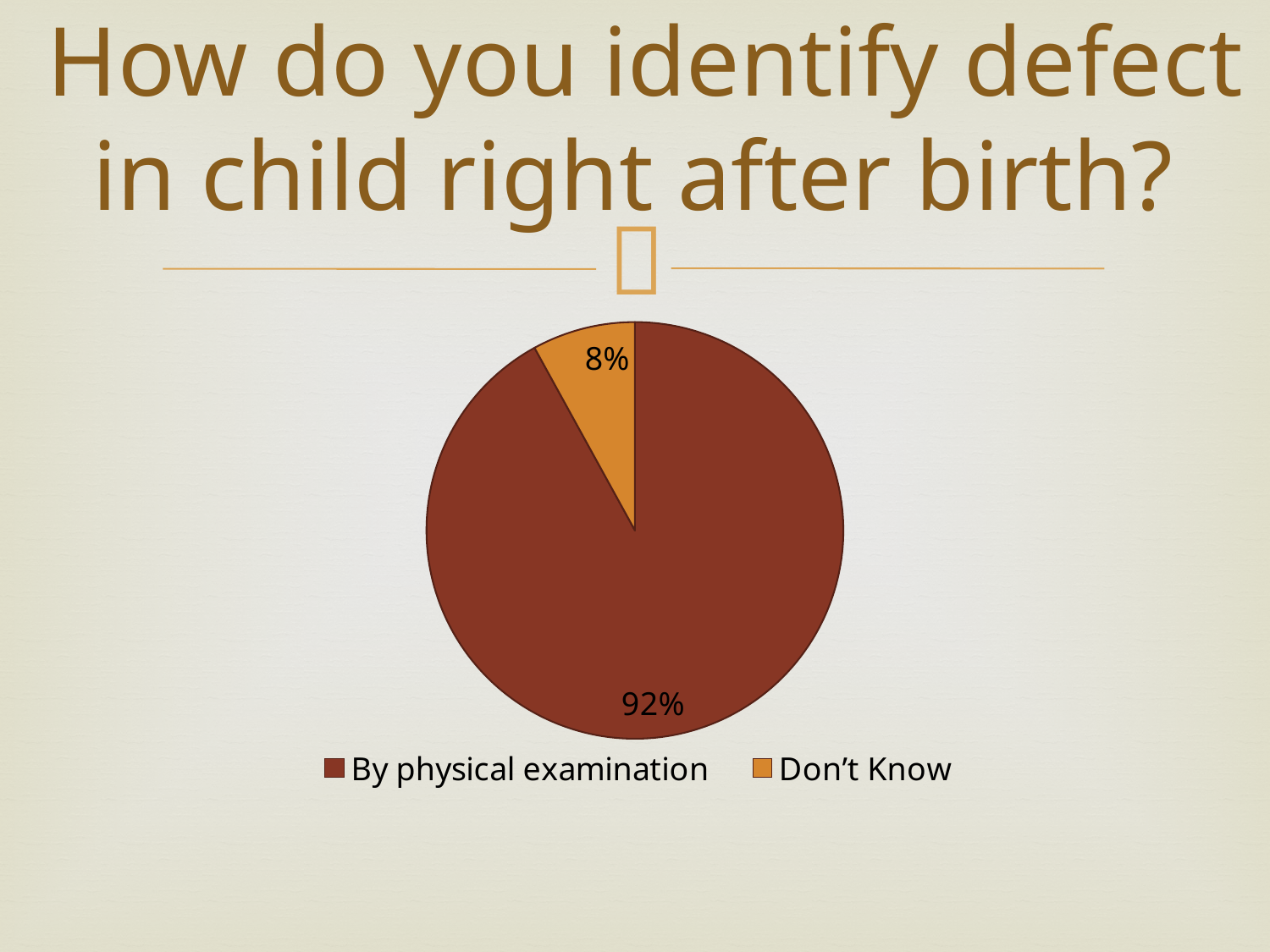
What colour is the 'Don't Know' slice? orange Which slice of the pie is the smallest? Don't Know What kind of chart is shown on the slide? pie chart How many slices does the pie chart have? 2 What percentage of the pie is labelled 'By physical examination'? 92% What is the difference in percentage points between the 'By physical examination' slice and the 'Don't Know' slice? 84 Which slice of the pie is the largest? By physical examination How many entries does the legend list? 2 What percentage of the pie is labelled 'Don't Know'? 8% Which is larger: the 'By physical examination' slice or the 'Don't Know' slice? By physical examination What share of the pie does the 'Don't Know' slice take? 8% What is the title of the slide above the pie chart? How do you identify defect in child right after birth?